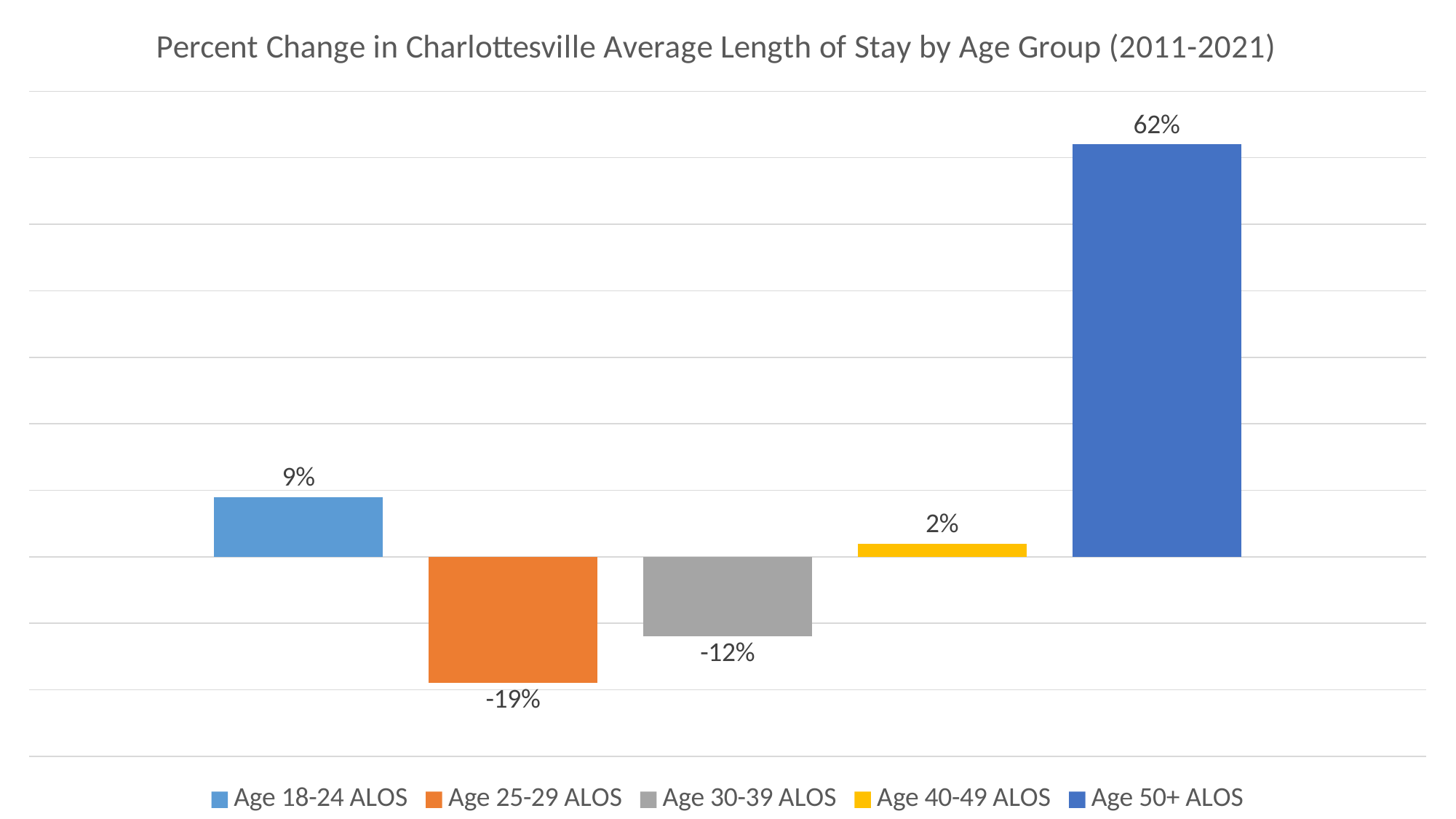
What kind of chart is shown on the slide? Bar chart What is the percent change in average length of stay for Age 18-24 ALOS? 9% How many age groups are plotted in the chart? 5 How many entries does the legend list? 5 Which age group has the highest percent change in average length of stay? Age 50+ ALOS What is the title of the chart? Percent Change in Charlottesville Average Length of Stay by Age Group (2011-2021) What is the difference between the percent change for Age 50+ ALOS and Age 18-24 ALOS? 53 percentage points Which has a larger percent change, Age 30-39 ALOS or Age 40-49 ALOS? Age 40-49 ALOS What is the percent change in average length of stay for Age 40-49 ALOS? 2% What is the percent change in average length of stay for Age 50+ ALOS? 62% Which age group has the lowest percent change in average length of stay? Age 25-29 ALOS What is the percent change in average length of stay for Age 25-29 ALOS? -19%